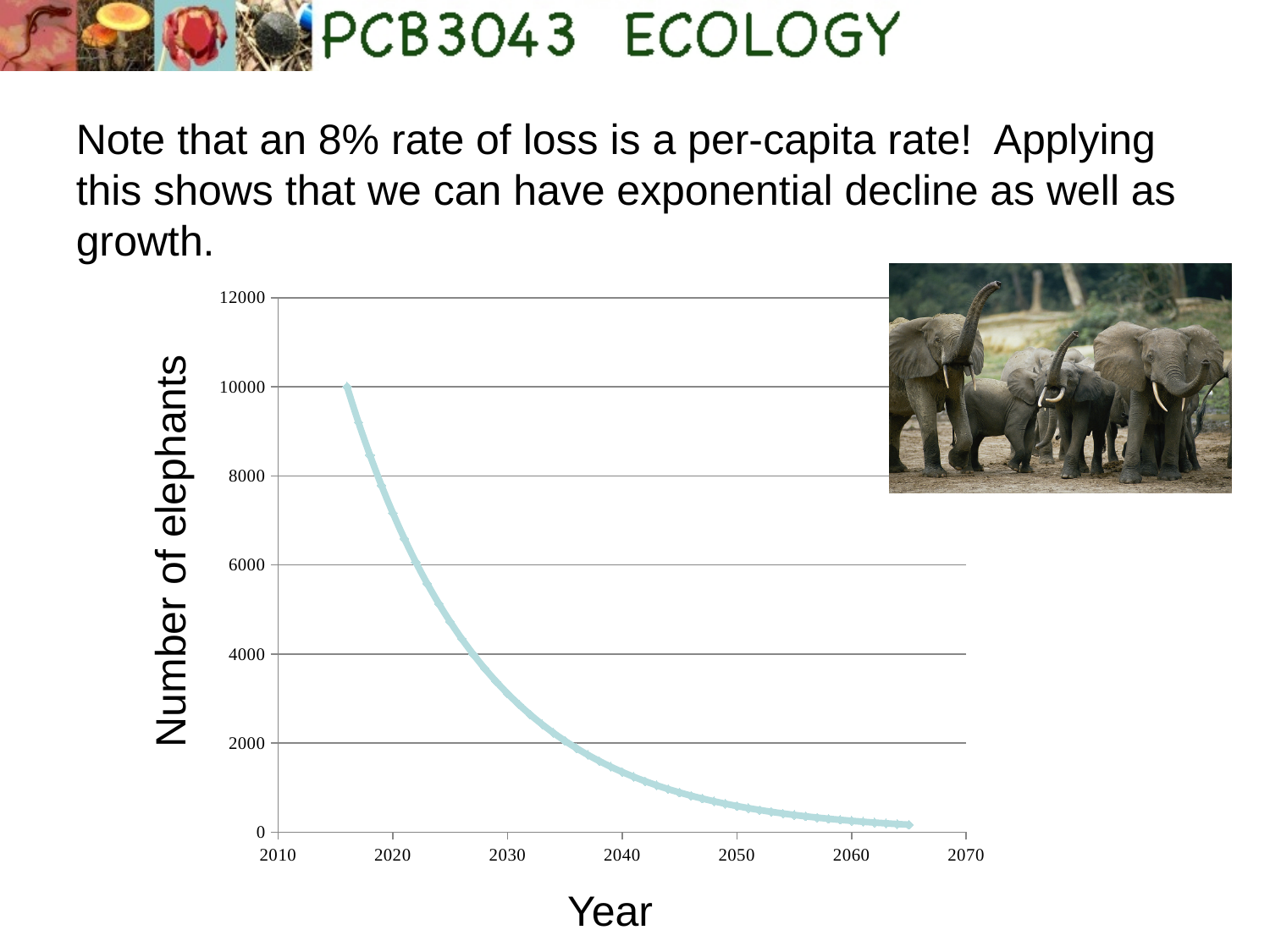
Is the number of elephants in 2030 greater or less than 2000? greater What kind of chart is shown on the slide? line chart Is the number of elephants in 2020 greater or less than 8000? less Which year has more elephants, 2020 or 2040? 2020 Is the number of elephants in 2040 greater or less than 2000? less Does the number of elephants rise or fall as the year increases? fall What is the label of the horizontal axis? Year What is the label of the vertical axis? Number of elephants